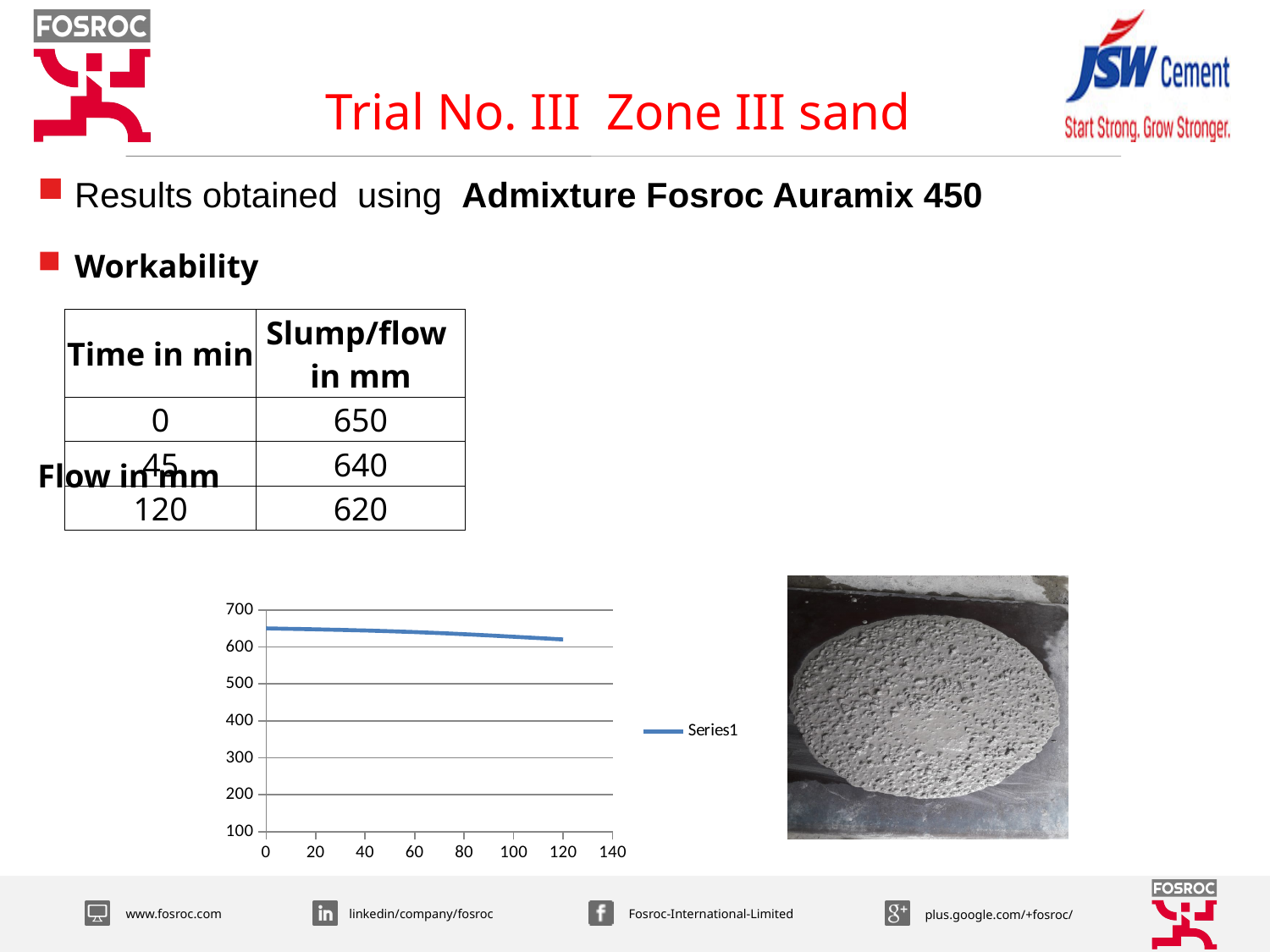
Is the plotted value at x = 0 greater or less than 600? greater Is the plotted value at x = 120 greater or less than 700? less According to the slide, what is the slump/flow in mm at 0 minutes? 650 What kind of chart is shown on the slide? line chart What is the difference in slump/flow between 0 minutes and 120 minutes? 30 What is the name of the series shown in the chart legend? Series1 Is the plotted value at x = 120 greater or less than 500? greater At which time in minutes is the slump/flow highest? 0 According to the slide, what is the slump/flow in mm at 120 minutes? 620 How many series does the chart legend list? 1 Do the plotted values rise or fall as the x axis increases from 0 to 120? fall What is the highest tick value shown on the chart's y axis? 700